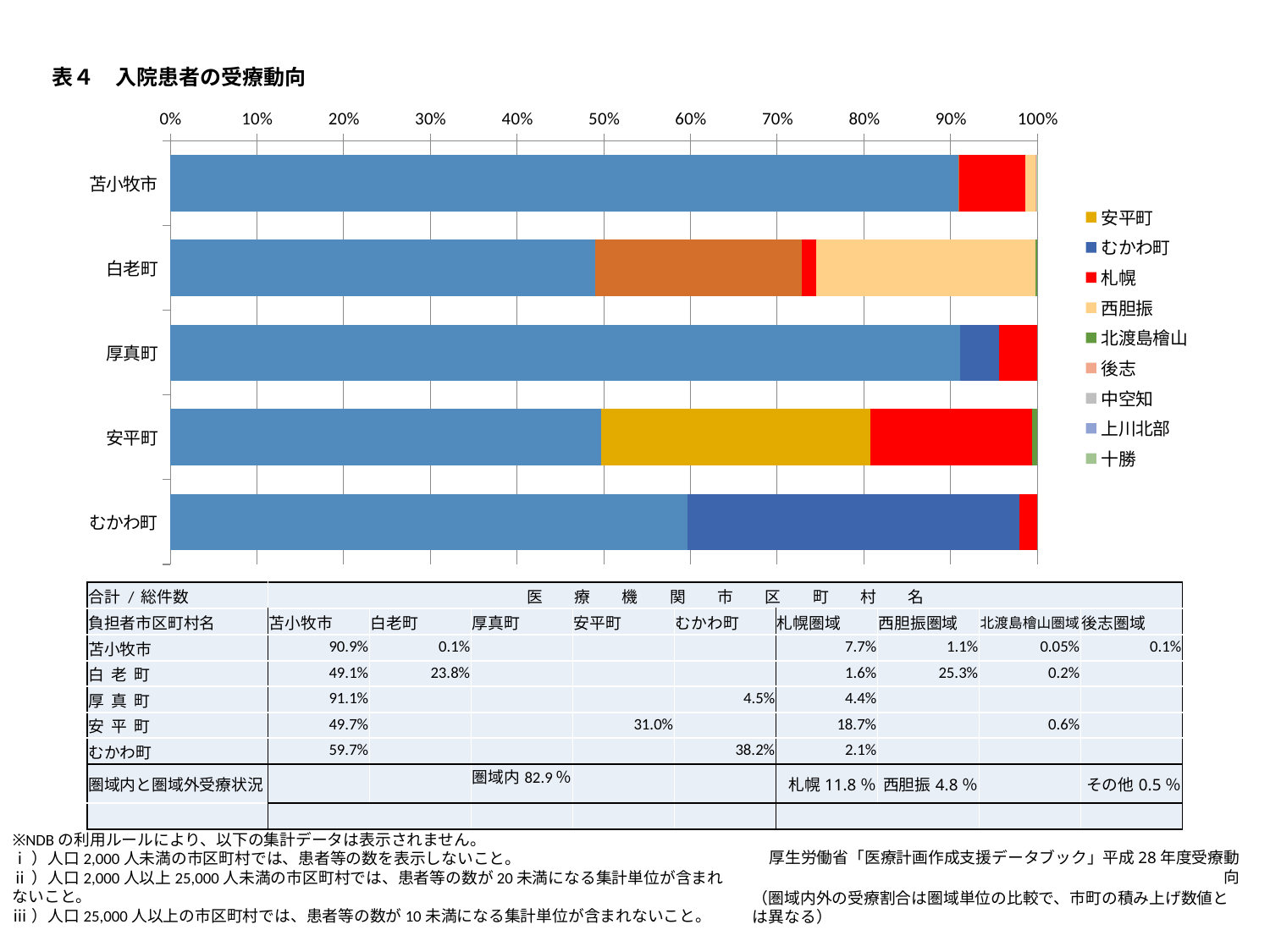
How many series does the chart legend list? 9 Which colour represents 札幌 in the chart legend? red Using the table values, what is the difference between the 苫小牧市 share for 苫小牧市 (90.9%) and for 白老町 (49.1%)? 41.8% What kind of chart is shown on the slide? bar chart According to the table under the chart, what share of 安平町 inpatients were treated in 安平町? 31.0% Which bar has the larger blue (苫小牧市) segment, 白老町 or むかわ町? むかわ町 Is the 苫小牧市 (blue) share of the 苫小牧市 bar greater or less than 90%? greater Is the 苫小牧市 (blue) share of the むかわ町 bar greater or less than 50%? greater According to the table under the chart, what share of むかわ町 inpatients were treated in むかわ町? 38.2% What is the title of the chart? 表４ 入院患者の受療動向 How many municipalities (categories) are plotted on the y axis of the chart? 5 Is the 苫小牧市 (blue) share of the 白老町 bar greater or less than 50%? less